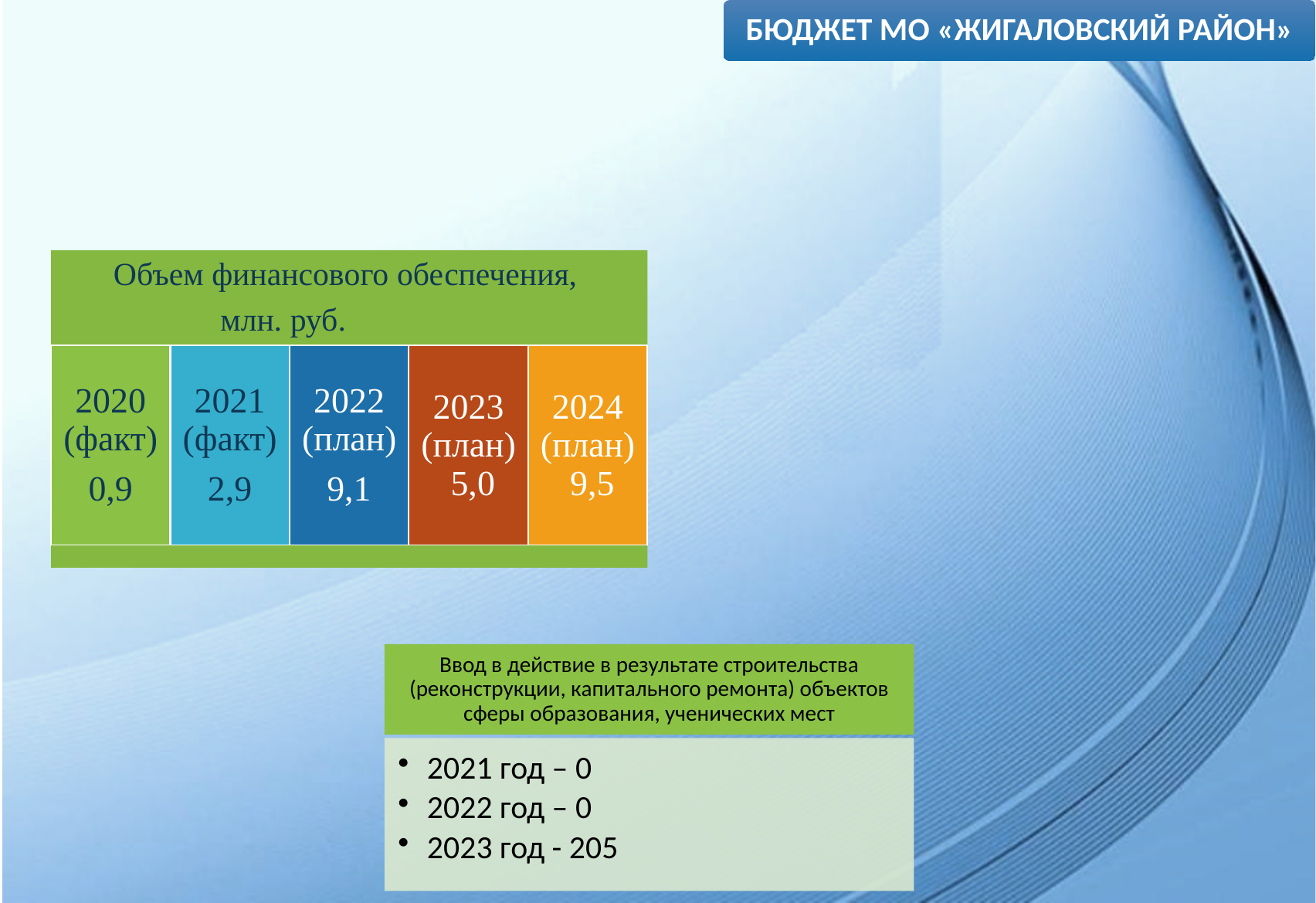
In the "Объем финансового обеспечения, млн. руб." table, which year has the highest value? 2024 (план) In the "Объем финансового обеспечения, млн. руб." table, what is the value for 2021 (факт)? 2,9 What is the title shown in the blue header at the top right of the slide? БЮДЖЕТ МО «ЖИГАЛОВСКИЙ РАЙОН» How many years are shown in the "Объем финансового обеспечения, млн. руб." table? 5 In the "Объем финансового обеспечения, млн. руб." table, what is the value for 2022 (план)? 9,1 In the "Объем финансового обеспечения, млн. руб." table, which is larger: the value for 2021 (факт) or 2023 (план)? 2023 (план) In the "Объем финансового обеспечения, млн. руб." table, what is the value for 2023 (план)? 5,0 In the "Объем финансового обеспечения, млн. руб." table, which year has the lowest value? 2020 (факт) In the box "Ввод в действие ... ученических мест", what is the value for 2023 год? 205 In the "Объем финансового обеспечения, млн. руб." table, what is the value for 2024 (план)? 9,5 In the "Объем финансового обеспечения, млн. руб." table, what is the value for 2020 (факт)? 0,9 In the "Объем финансового обеспечения, млн. руб." table, what is the difference between the 2022 (план) and 2023 (план) values? 4,1